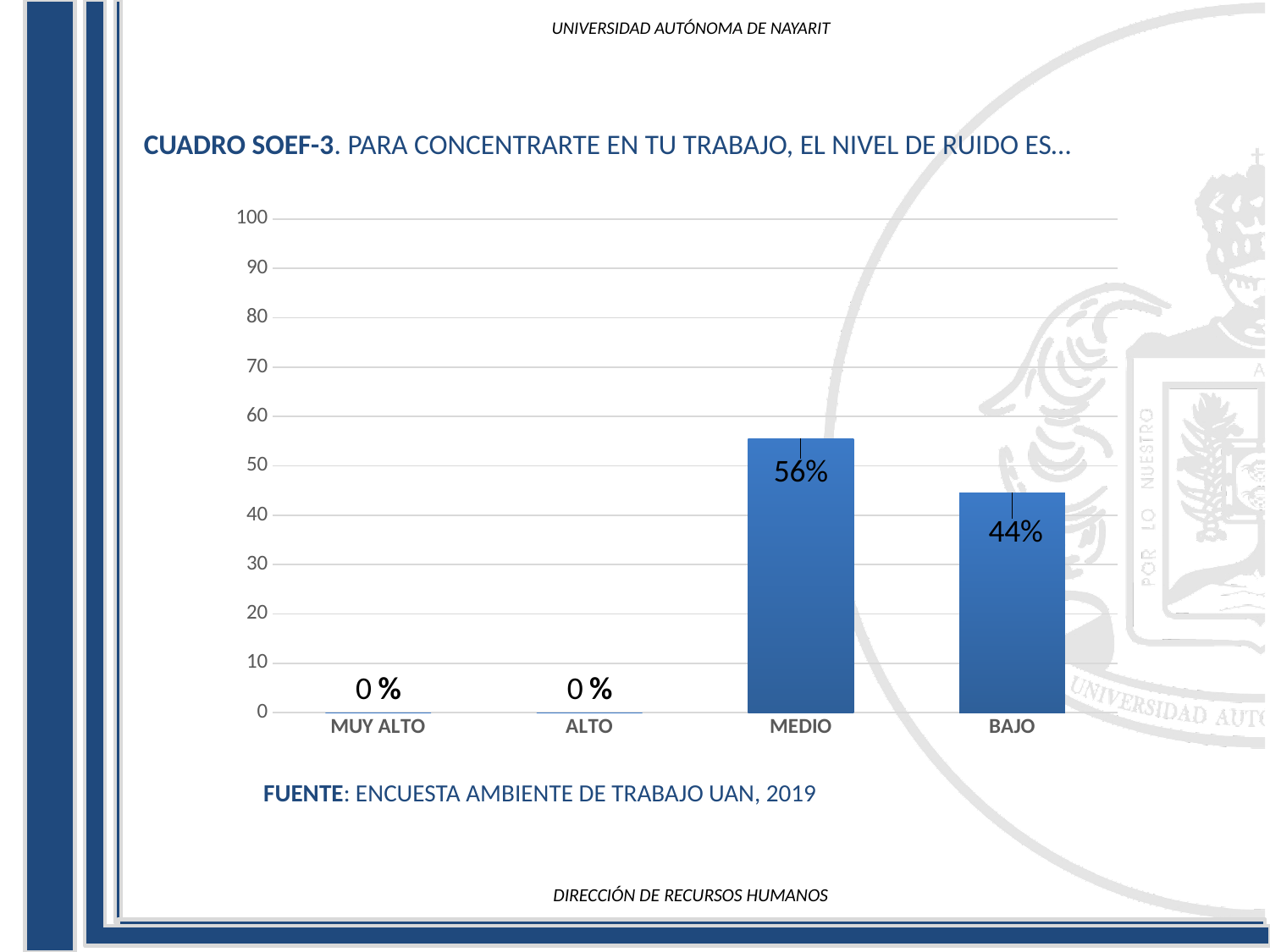
What is the value for MEDIO? 56% Is the value for MEDIO greater or less than 50? greater Is the value for BAJO greater or less than 50? less What kind of chart is shown on the slide? bar chart Which category has the highest value? MEDIO What is the difference between the values for MEDIO and BAJO? 12% What is the source cited below the chart? ENCUESTA AMBIENTE DE TRABAJO UAN, 2019 How many categories are shown on the x axis? 4 What is the value for BAJO? 44% What is the value for MUY ALTO? 0 % Which is larger, the value for MEDIO or the value for BAJO? MEDIO What is the value for ALTO? 0 %